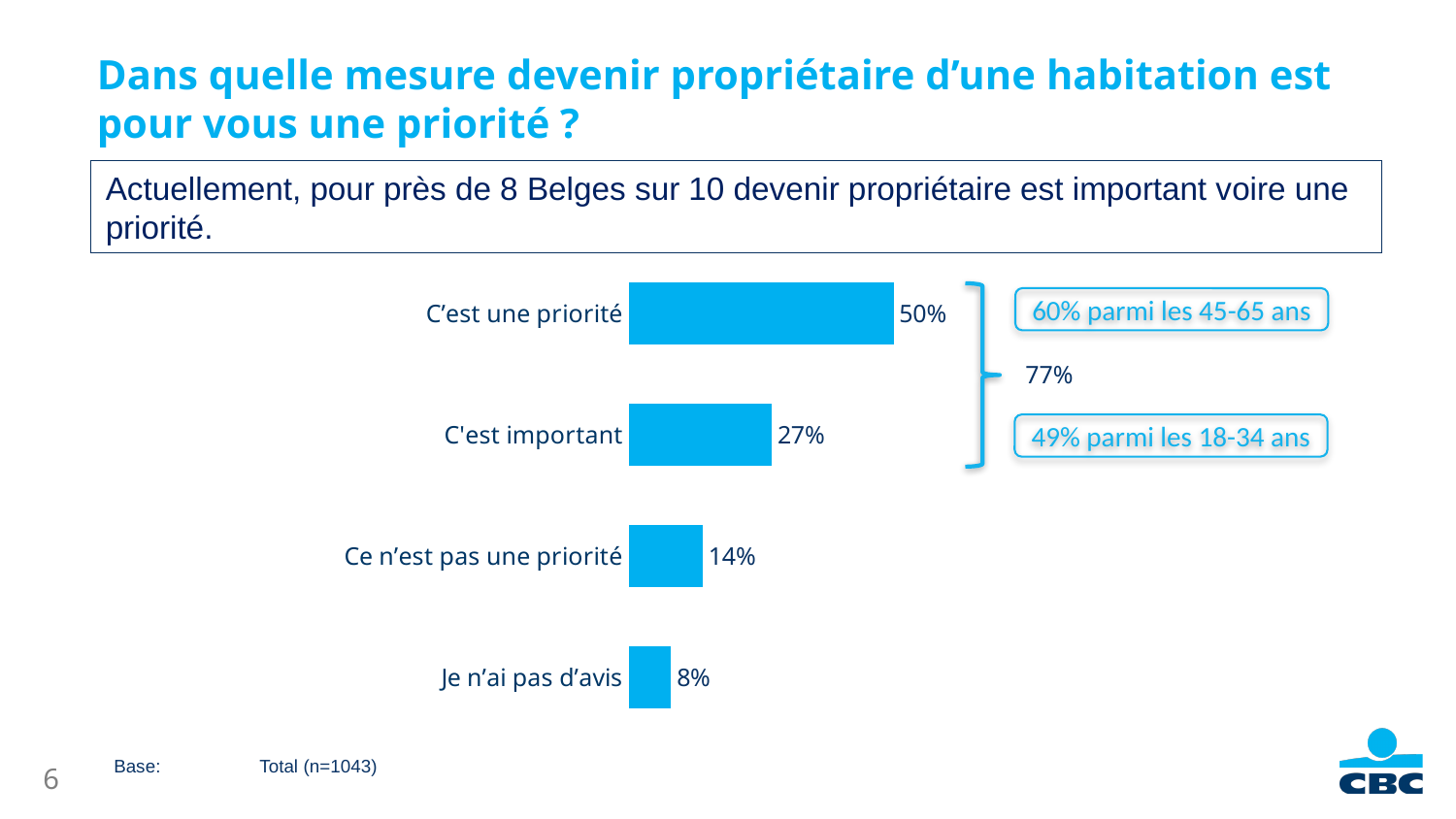
What is the value for "Je n'ai pas d'avis"? 8% What is the combined total of "C'est une priorité" and "C'est important" as shown by the bracket? 77% Which category has the highest value? C'est une priorité What is the difference between "C'est une priorité" and "C'est important"? 23% What is the sample size given in the base note? n=1043 Which is larger, "Ce n'est pas une priorité" or "Je n'ai pas d'avis"? Ce n'est pas une priorité What is the value for "C'est important"? 27% Which category has the lowest value? Je n'ai pas d'avis How many categories are shown in the chart? 4 What is the value for "Ce n'est pas une priorité"? 14% What kind of chart is shown on the slide? Bar chart What is the value for "C'est une priorité"? 50%